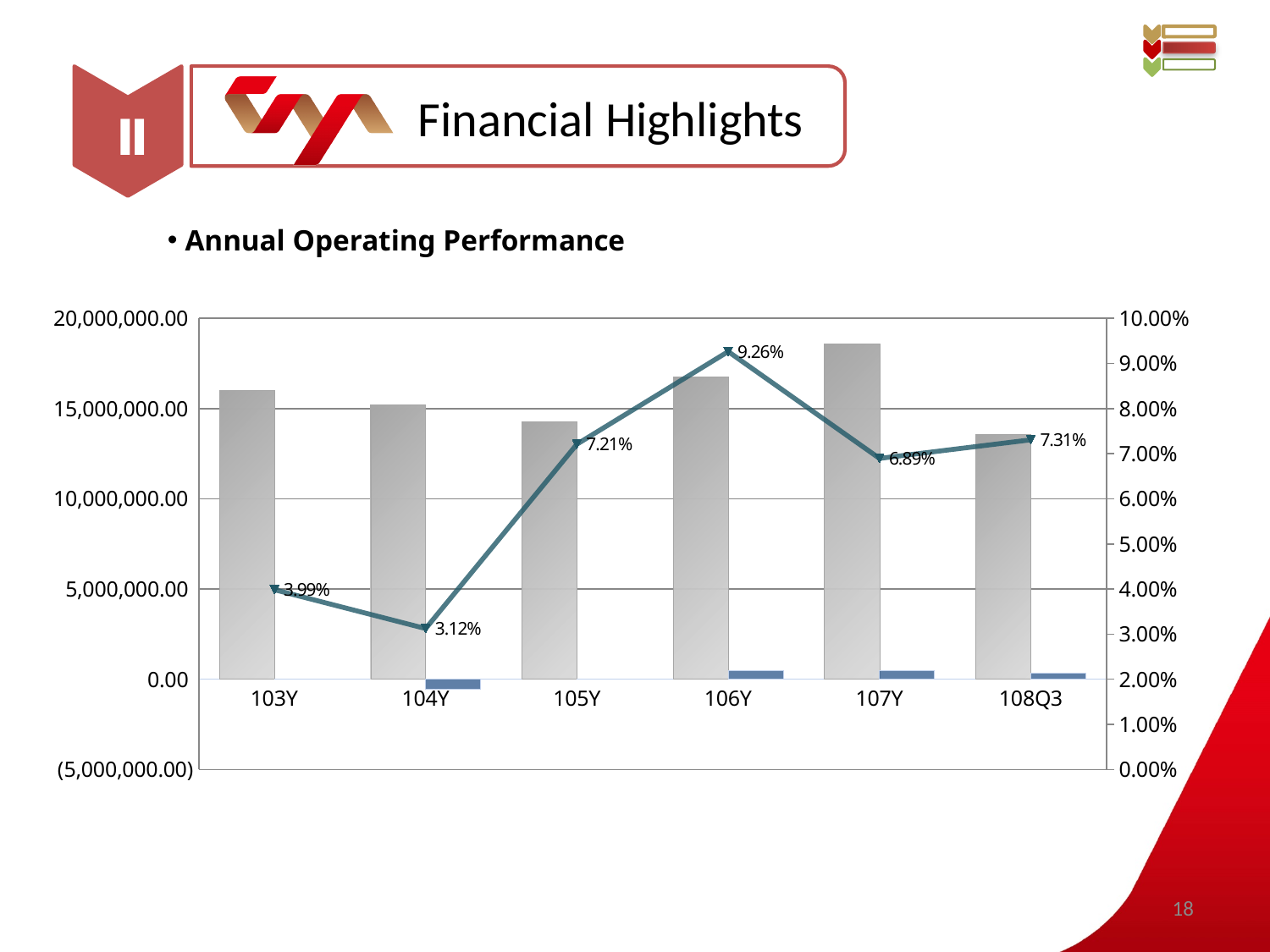
What is the percentage value shown on the line for 108Q3? 7.31% Is the gray bar for 107Y greater or less than 15,000,000.00? greater What is the percentage value shown on the line for 106Y? 9.26% Which category has the highest percentage value on the line? 106Y What is the difference between the line's percentage values for 106Y and 107Y? 2.37% Which category has the lowest percentage value on the line? 104Y Which has a higher percentage value on the line, 105Y or 108Q3? 108Q3 Does the line's percentage value rise or fall from 103Y to 104Y? fall What is the percentage value shown on the line for 104Y? 3.12% Which category has the tallest gray bar? 107Y Is the gray bar for 105Y greater or less than 15,000,000.00? less How many categories are shown on the x axis? 6